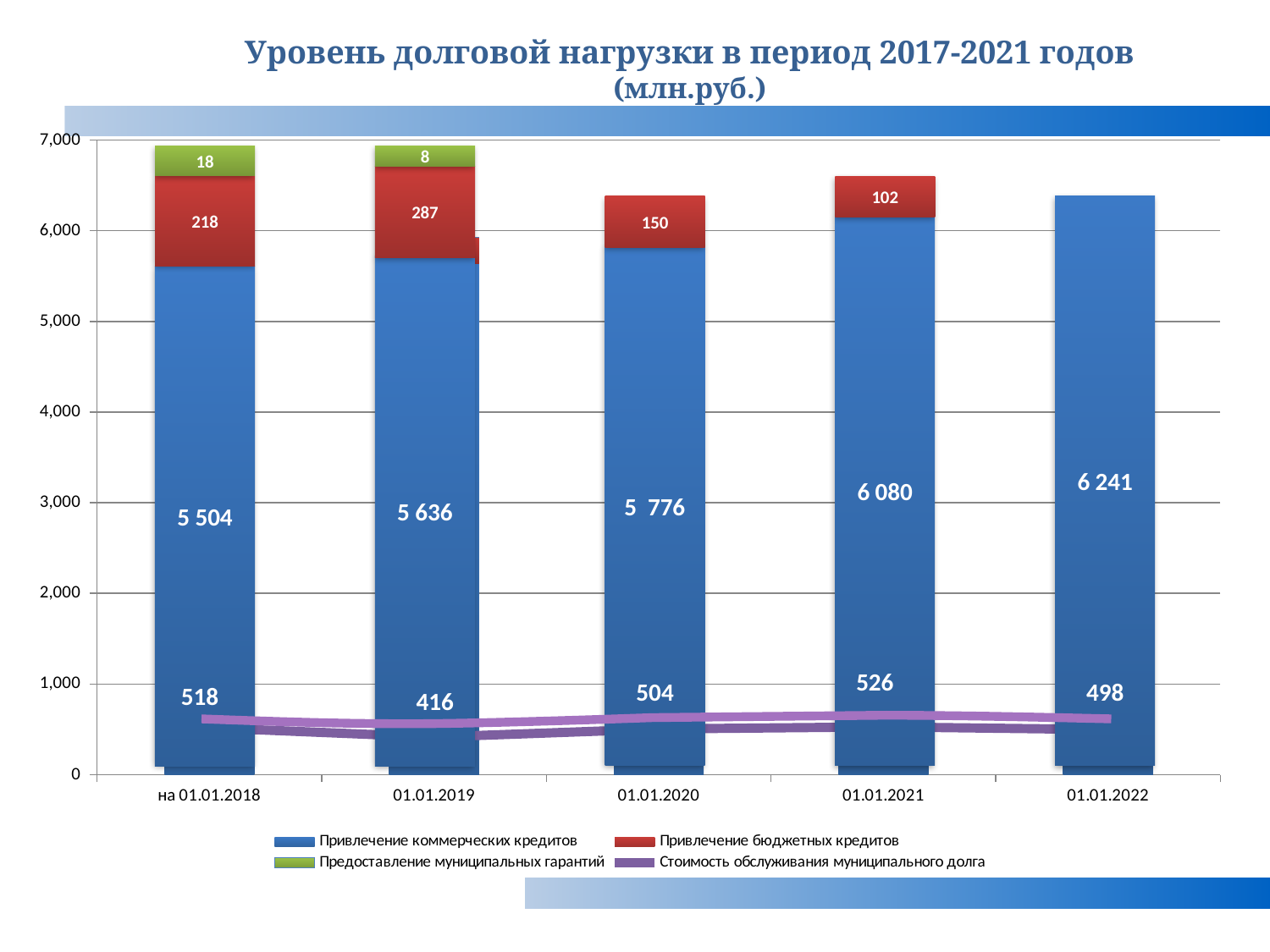
What is the total of the stacked bar for 01.01.2021 (Привлечение коммерческих кредитов plus Привлечение бюджетных кредитов)? 6 182 What is the value of Привлечение коммерческих кредитов on 01.01.2022? 6 241 What is the value of Стоимость обслуживания муниципального долга on 01.01.2020? 504 What is the value of Привлечение бюджетных кредитов on 01.01.2019? 287 What is the difference between Привлечение коммерческих кредитов on 01.01.2022 and on 01.01.2018? 737 In which period is Стоимость обслуживания муниципального долга the lowest? 01.01.2019 In which period is Привлечение коммерческих кредитов the highest? 01.01.2022 How many periods are shown on the x axis? 5 Which is larger: Привлечение бюджетных кредитов on 01.01.2019 or on 01.01.2018? 01.01.2019 How many series does the legend list? 4 Does Привлечение коммерческих кредитов rise or fall from 01.01.2018 to 01.01.2022? rise What is the value of Предоставление муниципальных гарантий on 01.01.2018? 18